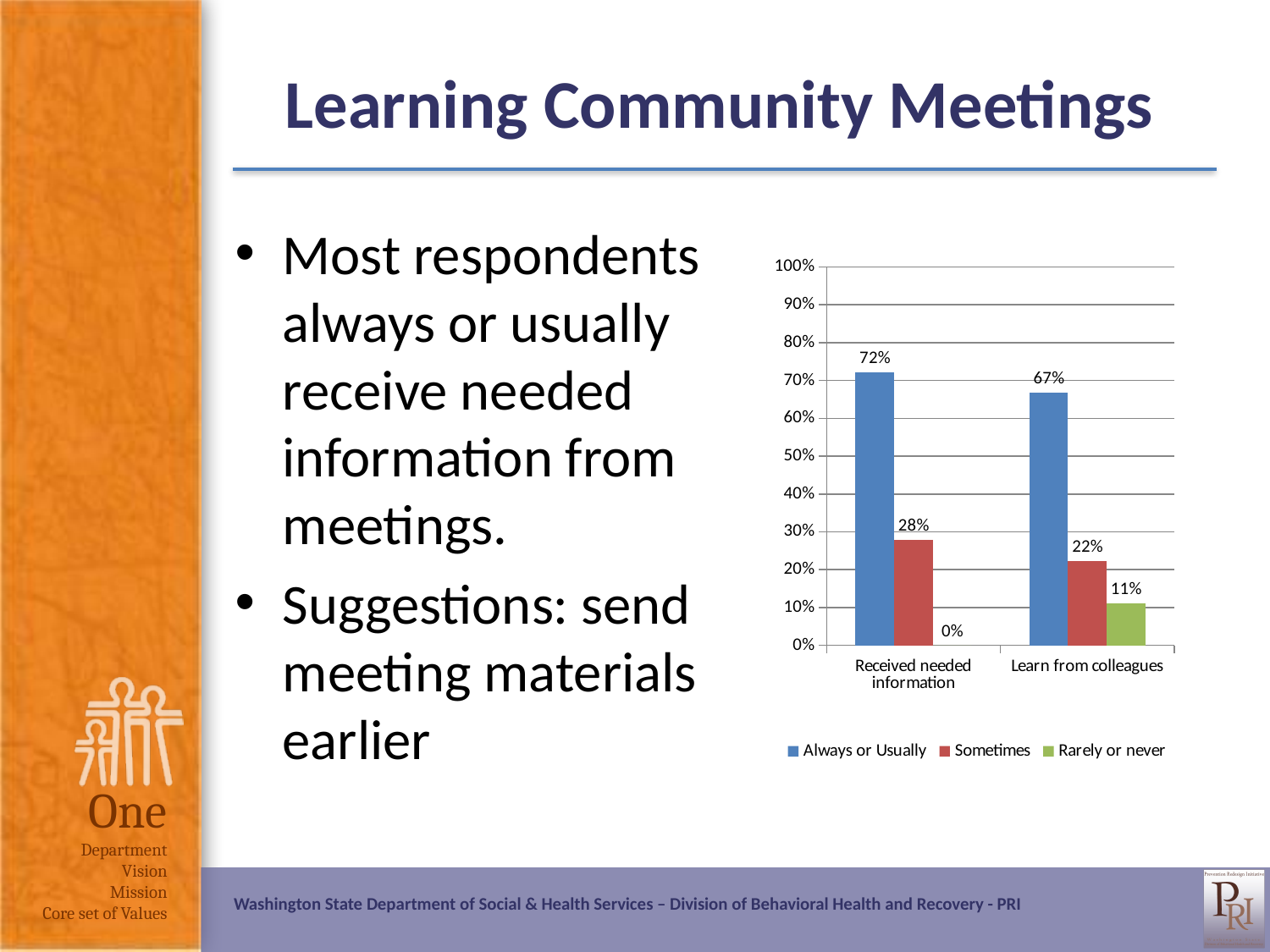
What percentage of respondents said they Always or Usually received needed information? 72% What is the value for Rarely or never in the Received needed information category? 0% Which is larger: the Sometimes value for Received needed information or for Learn from colleagues? Received needed information How many series does the legend list? 3 How many categories are shown on the x axis? 2 What is the difference between the Always or Usually values for Received needed information and Learn from colleagues? 5% What is the value for Sometimes in the Learn from colleagues category? 22% Which series has the highest value in the Learn from colleagues category? Always or Usually What kind of chart is shown on the slide? Bar chart What colour are the bars for the Sometimes series? Red What is the value for Rarely or never in the Learn from colleagues category? 11% Which series has the lowest value in the Received needed information category? Rarely or never